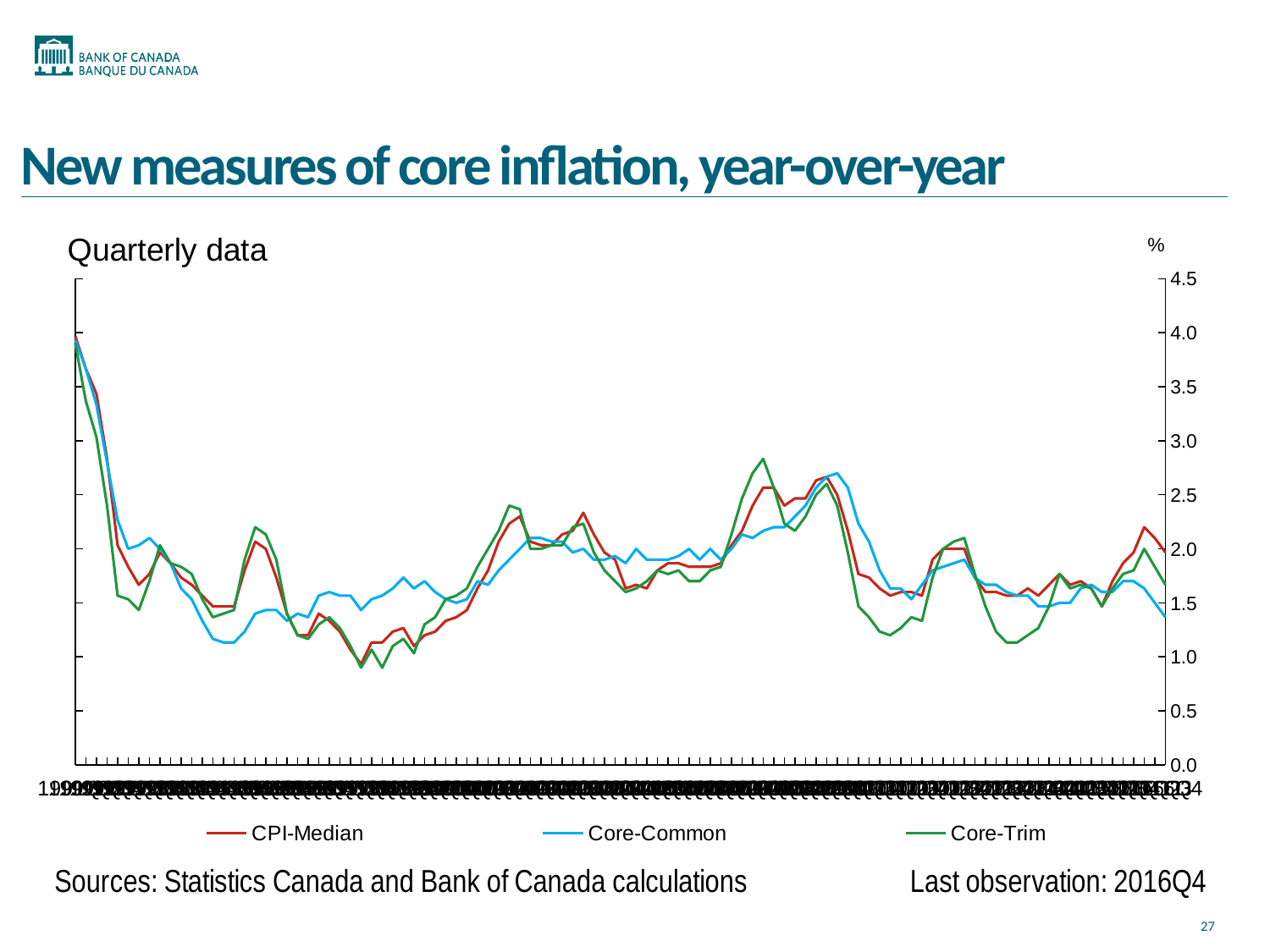
Is the value for Core-Common at the last observation (2016Q4) greater or less than 1.0? greater Is the lowest value reached by Core-Common greater or less than 1.0? greater At the last observation (2016Q4), which is larger: the value for Core-Trim or the value for Core-Common? Core-Trim Is the value for Core-Common at the last observation (2016Q4) greater or less than 1.5? less What is the title of the chart on the slide? New measures of core inflation, year-over-year How many series does the legend list? 3 Do the values of the three series generally rise or fall from the start of the period to the end? fall What kind of chart is shown on the slide? line chart Which colour is used for the Core-Common line? blue